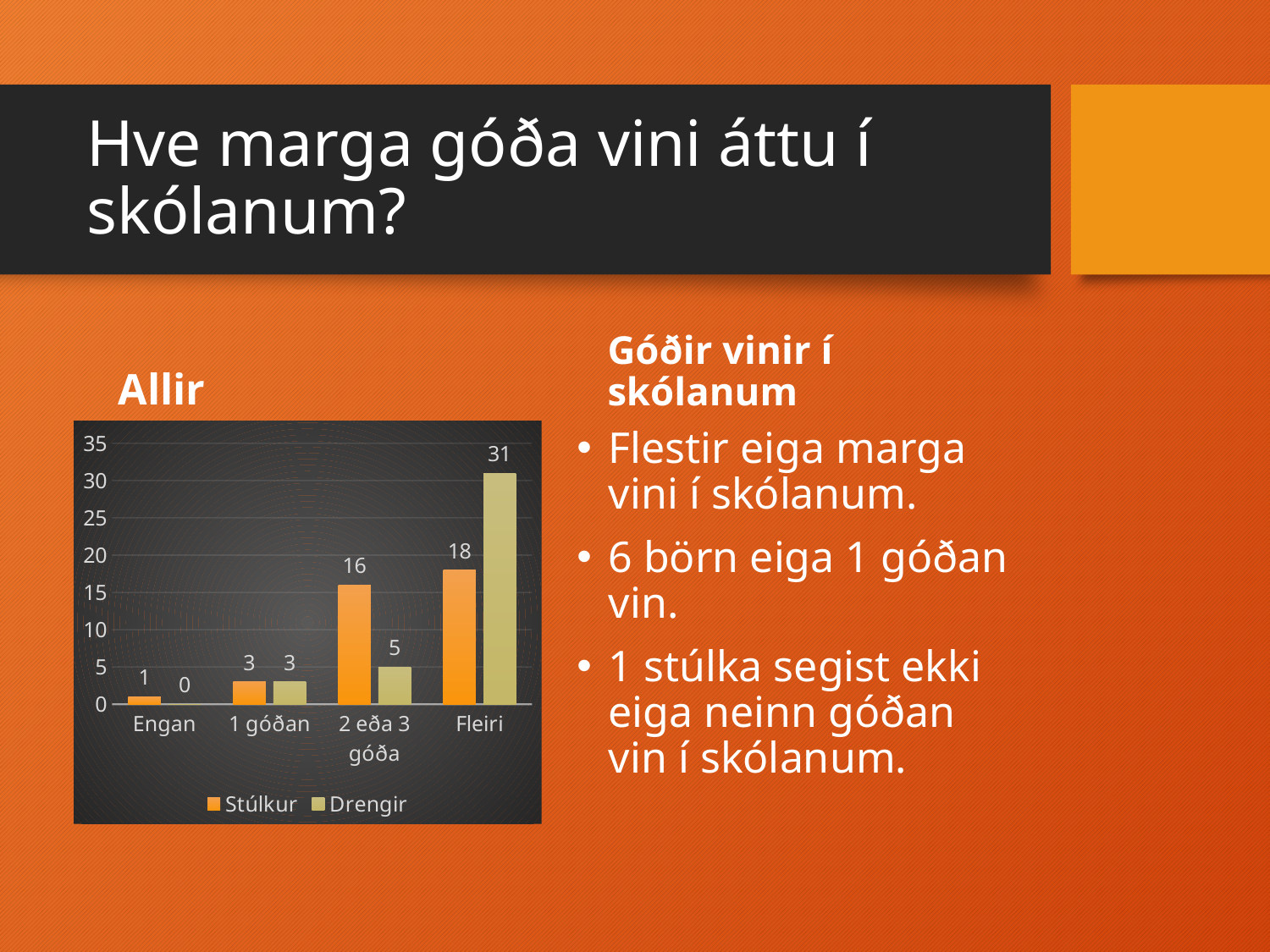
What is the title of the chart? Allir What is the value for Drengir in the 2 eða 3 góða category? 5 What kind of chart is shown on the slide? Bar chart Which category has the lowest value for Stúlkur? Engan Which is larger in the 2 eða 3 góða category, Stúlkur or Drengir? Stúlkur Which category has the highest value for Drengir? Fleiri What is the value for Stúlkur in the Fleiri category? 18 How many series does the legend list? 2 Is the value for Drengir in the Fleiri category greater or less than 30? greater How many categories are shown on the x axis? 4 What is the value for Drengir in the Engan category? 0 What is the difference between Drengir and Stúlkur in the Fleiri category? 13